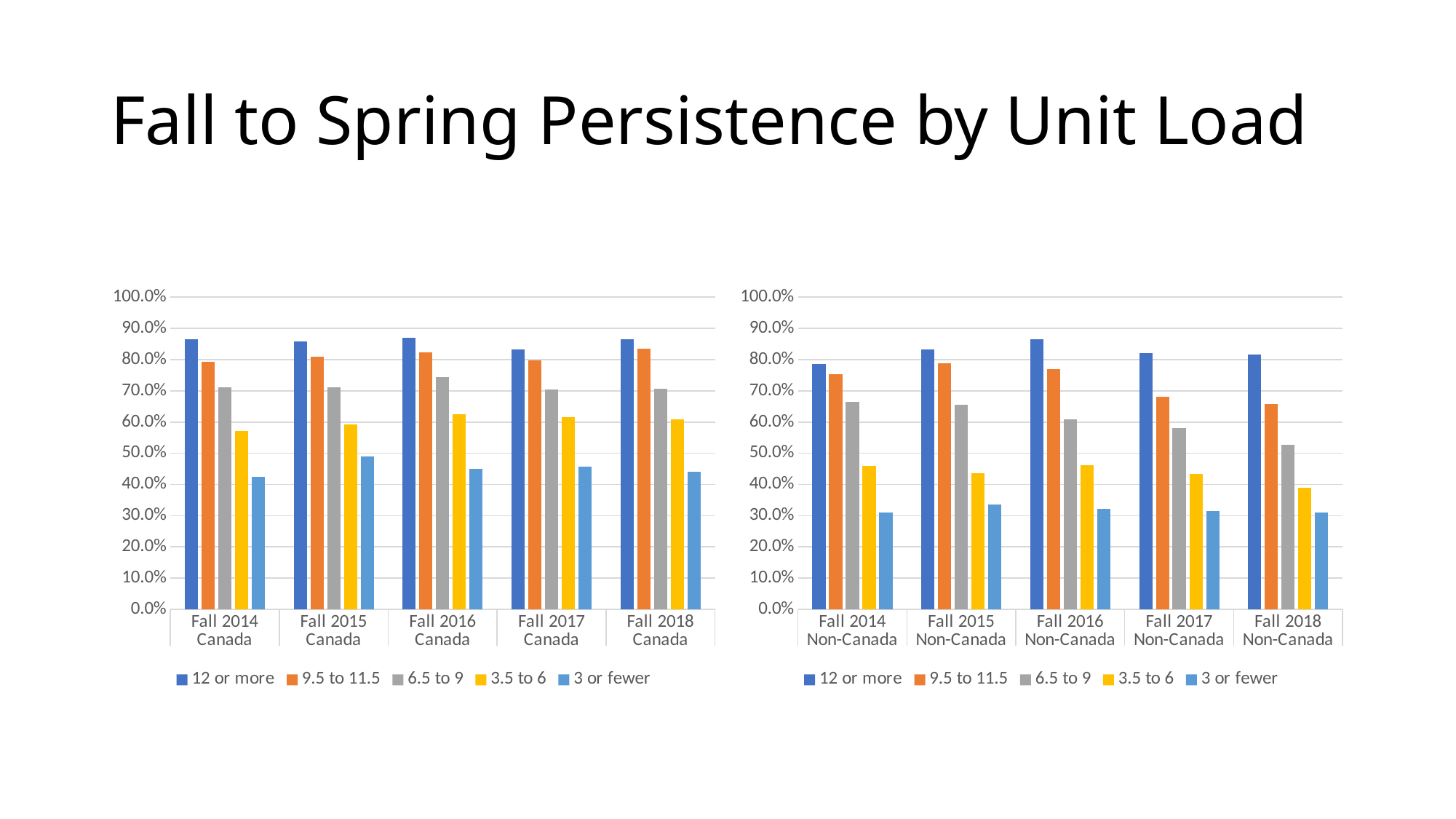
In the right chart (Non-Canada), which series has the lowest value for Fall 2018 Non-Canada? 3 or fewer In the right chart (Non-Canada), is the value for 12 or more in Fall 2016 Non-Canada greater or less than 80%? greater In the left chart (Canada), is the value for 3 or fewer in Fall 2014 Canada greater or less than 50%? less In the right chart (Non-Canada), which is larger for the 9.5 to 11.5 series: Fall 2014 Non-Canada or Fall 2018 Non-Canada? Fall 2014 Non-Canada In the left chart (Canada), which series has the highest value for Fall 2017 Canada? 12 or more How many categories are shown on the x axis of the left chart (Canada)? 5 How many series does the legend of the right chart (Non-Canada) list? 5 In the left chart (Canada), which is larger for Fall 2015 Canada: 12 or more or 3 or fewer? 12 or more In the right chart (Non-Canada), is the value for 3 or fewer in Fall 2015 Non-Canada greater or less than 40%? less What kind of chart is the left chart (Canada)? bar chart What is the first entry in the legend of the left chart (Canada)? 12 or more